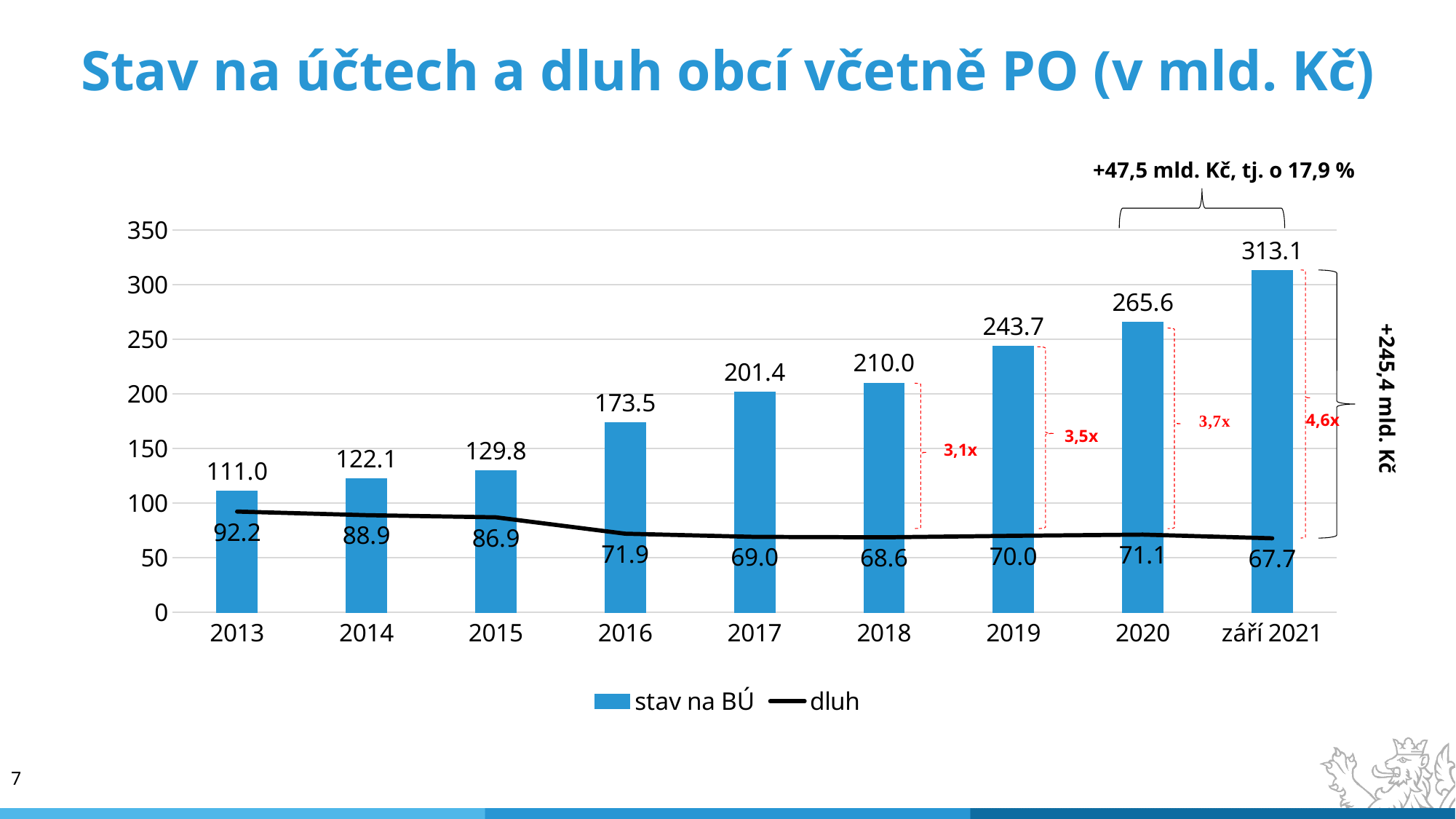
Does 'stav na BÚ' rise or fall from 2013 to září 2021? rise How many categories are shown on the x axis? 9 How many series does the legend list? 2 What is the value of 'dluh' for 2019? 70.0 What kind of chart is used for the 'stav na BÚ' series? bar chart What is the value of 'stav na BÚ' for září 2021? 313.1 What is the difference between 'stav na BÚ' in 2020 and in 2019? 21.9 What is the value of 'stav na BÚ' for 2016? 173.5 Which category has the lowest value for 'stav na BÚ'? 2013 Which category has the highest value for 'dluh'? 2013 Which is larger: 'dluh' in 2014 or 'dluh' in 2015? 2014 Which category has the highest value for 'stav na BÚ'? září 2021